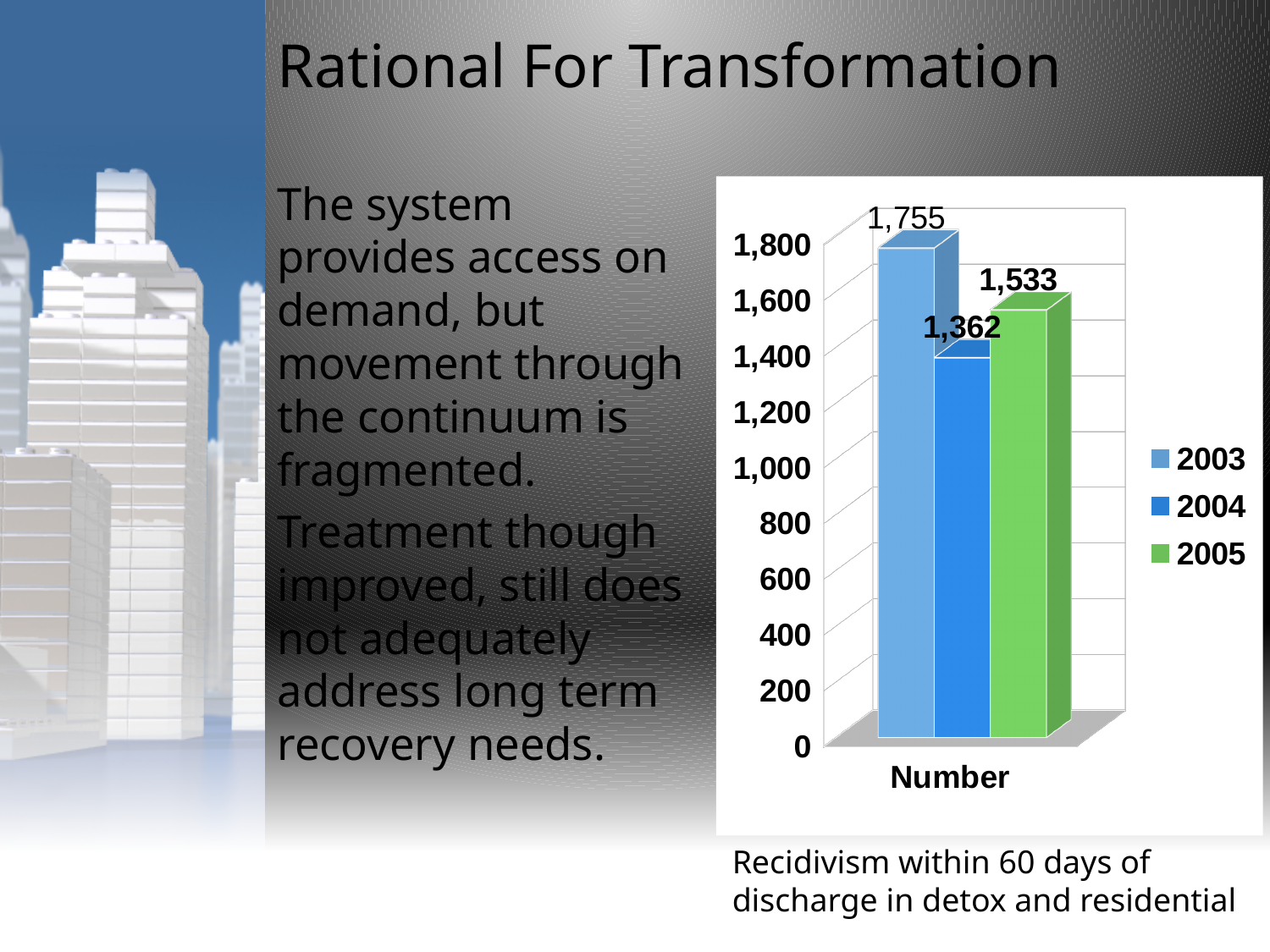
What is the value for 2003 in the chart? 1,755 What is the difference between the values for 2003 and 2004? 393 Which is larger, the value for 2003 or the value for 2005? 2003 Which year has the highest value in the chart? 2003 Is the value for 2004 greater or less than 1,400? less What is the value for 2005 in the chart? 1,533 Which year has the lowest value in the chart? 2004 What is the label on the x axis of the chart? Number What is the value for 2004 in the chart? 1,362 What kind of chart is shown on the slide? bar chart How many series does the legend list? 3 What is the difference between the values for 2005 and 2004? 171